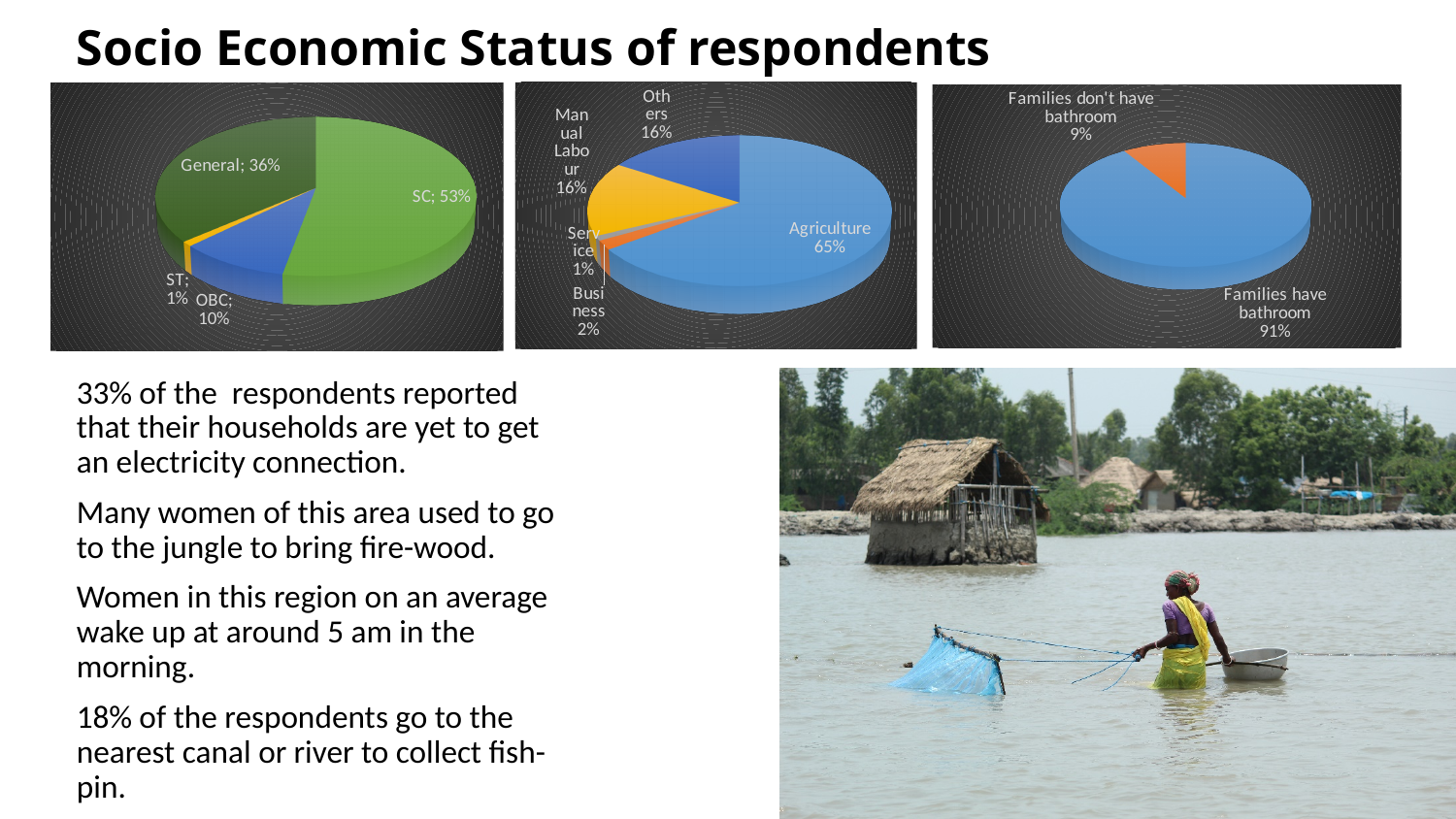
How many categories does the left pie chart show? 4 In the middle pie chart, which category has the largest share? Agriculture In the middle pie chart, which is larger, Business or Service? Business What type of chart is the right chart on the slide? Pie chart In the left pie chart, what percentage is labelled General? 36% In the right pie chart, what percentage of families don't have a bathroom? 9% In the middle pie chart, what share is Agriculture? 65% In the left pie chart, what is the difference between the SC and OBC shares? 43% In the right pie chart, what percentage of families have a bathroom? 91% How many categories does the middle pie chart show? 5 In the left pie chart, what share of respondents are SC? 53% In the left pie chart, which category has the smallest share? ST